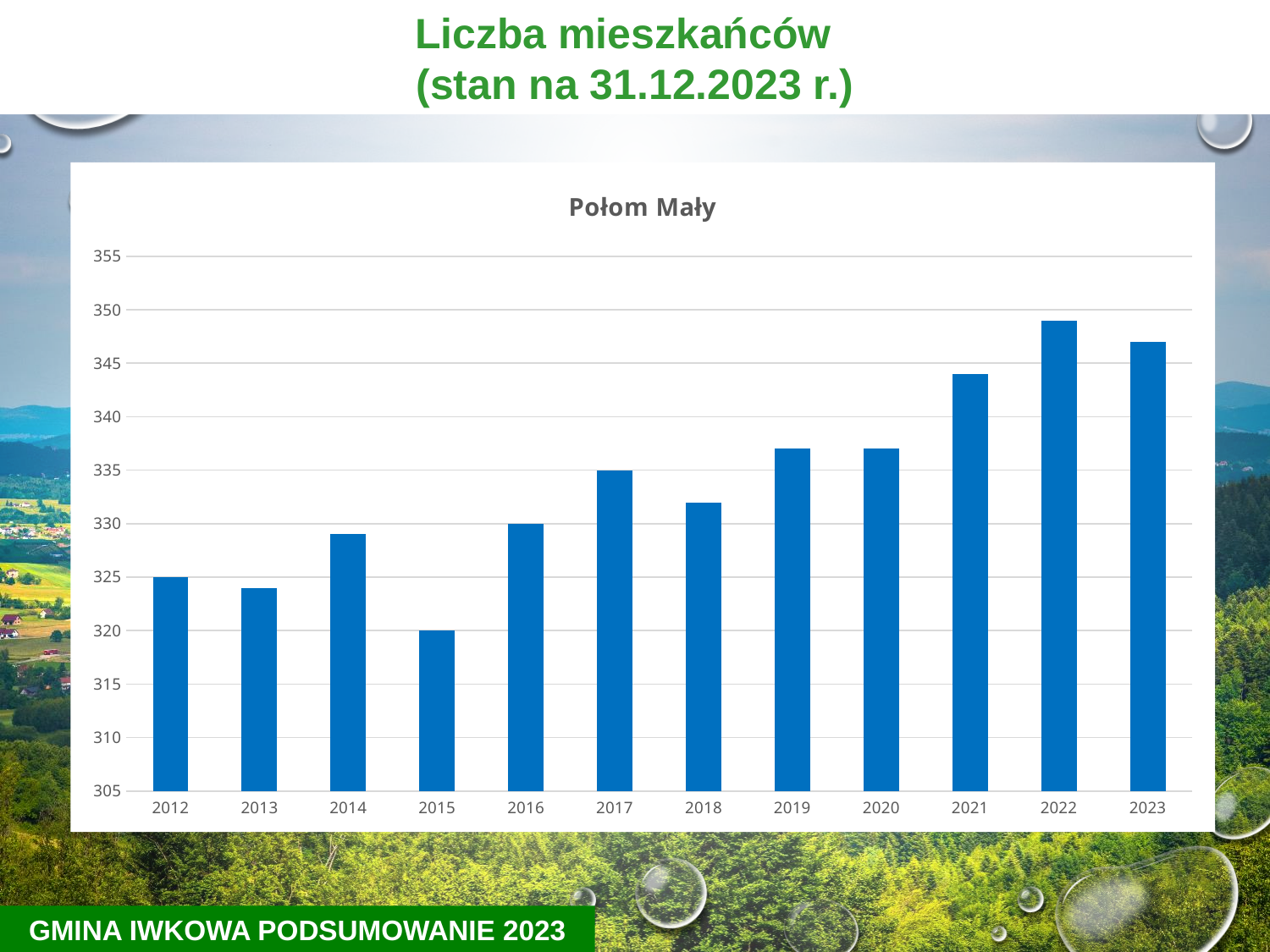
How many years are shown on the x axis of the chart? 12 What is the value for 2017? 335 What is the difference between the values for 2017 and 2015? 15 Which year has the lowest value? 2015 What is the value for 2015? 320 Is the value for 2021 greater or less than 340? greater Which is larger, the value for 2014 or the value for 2018? 2018 What is the value for 2012? 325 Do the values generally rise or fall from 2015 to 2022? rise Which year has the highest value? 2022 What is the title of the chart? Połom Mały What type of chart is shown on the slide? bar chart